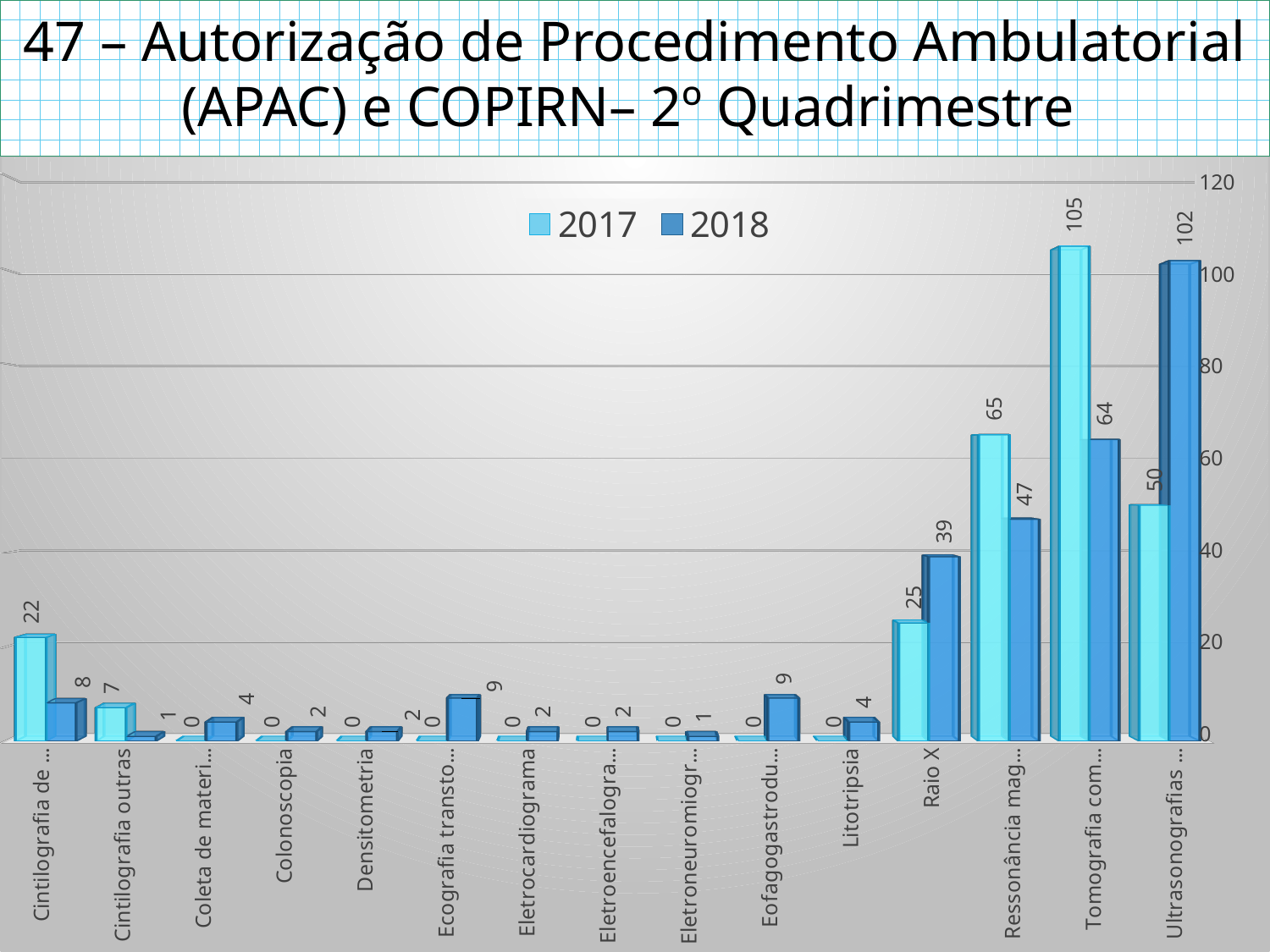
How many categories are shown on the x axis? 15 How many series does the legend list? 2 What is the 2018 value for Colonoscopia? 2 What is the 2018 value for Litotripsia? 4 What is the 2017 value for Densitometria? 0 What is the 2017 value for Cintilografia outras? 7 What is the 2018 value for Raio X? 39 What kind of chart is shown on the slide? bar chart For Raio X, which series has the larger value, 2017 or 2018? 2018 What is the 2017 value for Raio X? 25 For Cintilografia outras, which series has the larger value, 2017 or 2018? 2017 What is the difference between the 2018 and 2017 values for Raio X? 14